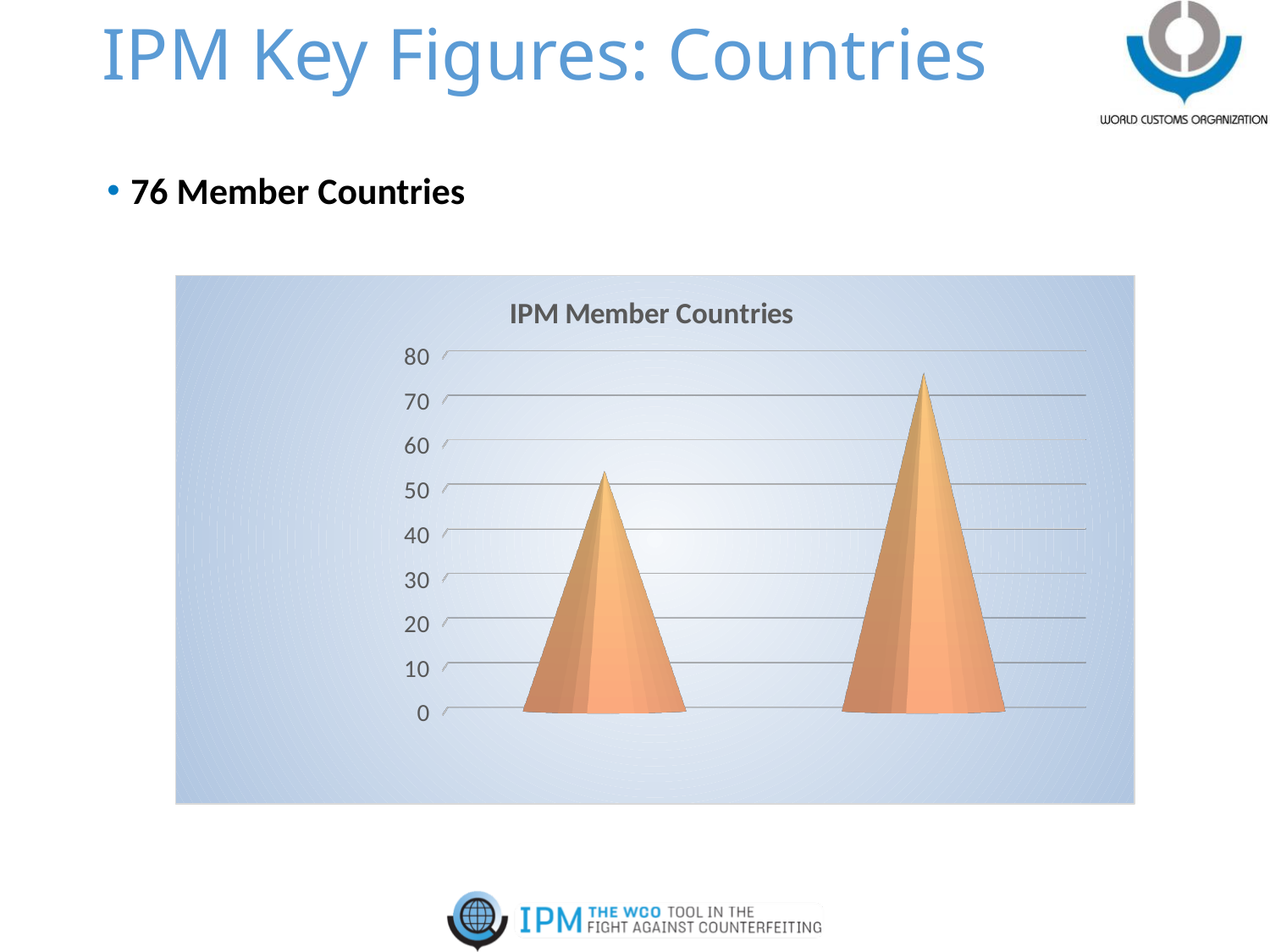
Is the value of the right bar greater or less than 80? less What kind of chart is shown on the slide? bar chart What is the highest value shown on the vertical axis of the chart? 80 Is the value of the left bar greater or less than 40? greater Is the value of the right bar greater or less than 70? greater Do the bar values rise or fall from left to right? rise Which bar has the highest value in the chart? the right bar Which bar has the lowest value in the chart? the left bar How many bars are plotted in the chart? 2 What is the title of the chart? IPM Member Countries Which bar is taller, the left bar or the right bar? the right bar